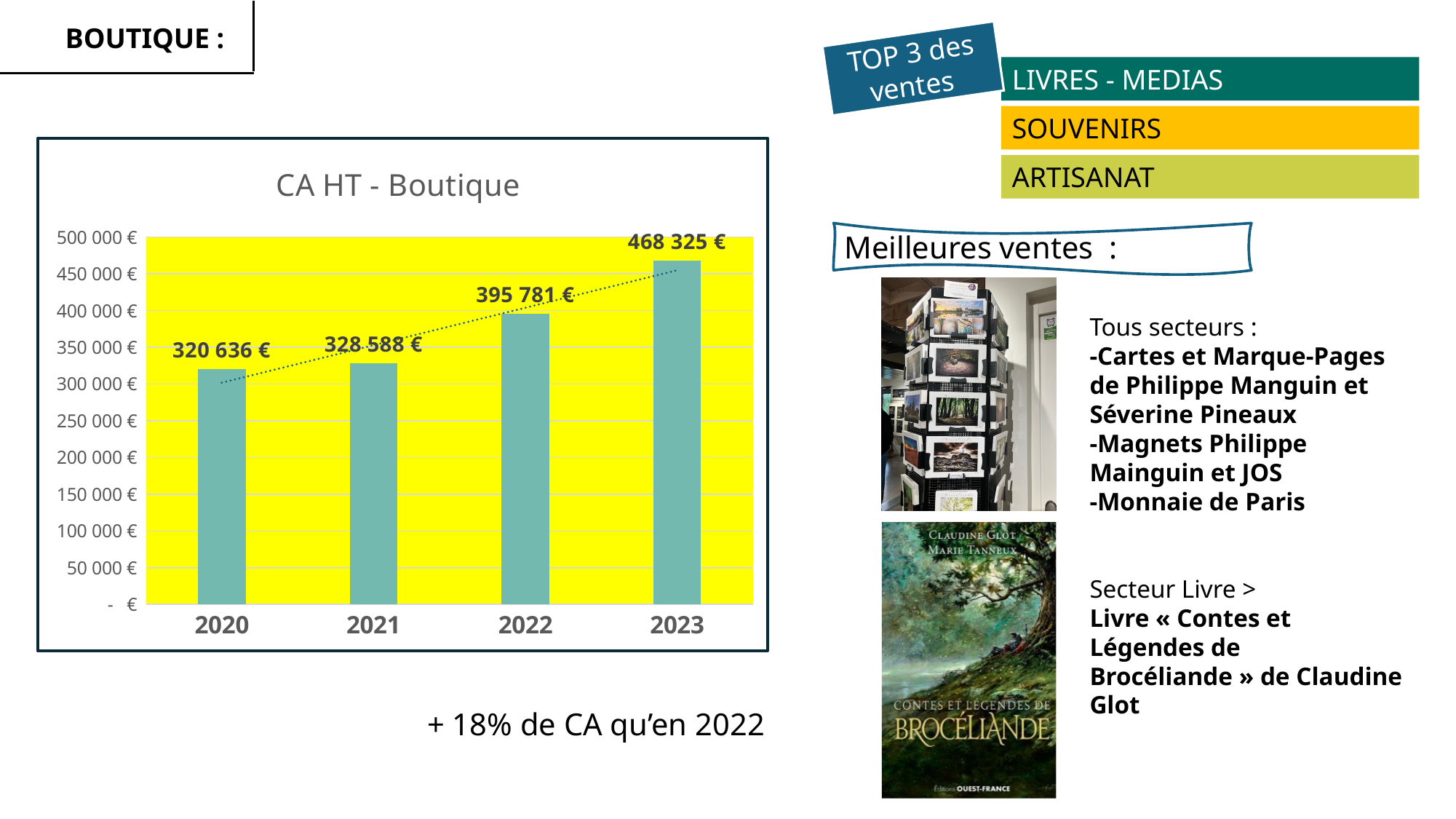
Which year has the lowest value in the CA HT - Boutique chart? 2020 Is the value for 2021 greater or less than 350 000 € in the CA HT - Boutique chart? less What is the difference between the 2021 and 2020 values in the CA HT - Boutique chart? 7 952 € What kind of chart is the CA HT - Boutique chart? bar chart What is the value for 2022 in the CA HT - Boutique chart? 395 781 € What is the value for 2023 in the CA HT - Boutique chart? 468 325 € What is the value for 2020 in the CA HT - Boutique chart? 320 636 € What is the difference between the 2023 and 2022 values in the CA HT - Boutique chart? 72 544 € How many years are shown on the x axis of the CA HT - Boutique chart? 4 Is the value for 2022 larger or smaller than the value for 2021 in the CA HT - Boutique chart? larger Which year has the highest value in the CA HT - Boutique chart? 2023 Do the values in the CA HT - Boutique chart rise or fall from 2020 to 2023? rise